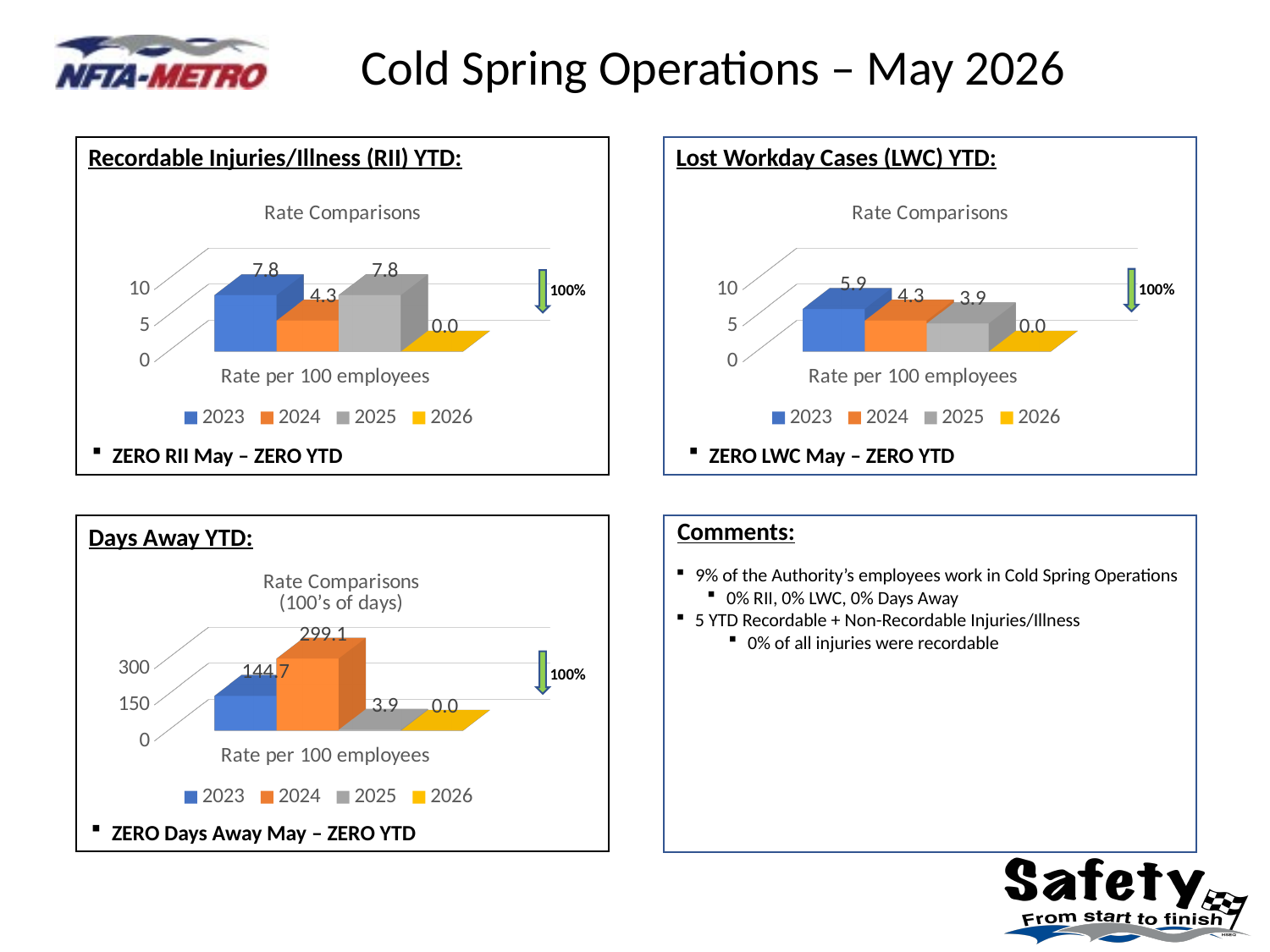
In the Recordable Injuries/Illness (RII) YTD chart, what is the value for 2024? 4.3 In the Days Away YTD chart, is the value for 2024 greater or less than 150? greater What kind of chart is the Lost Workday Cases (LWC) YTD chart? Bar chart In the Days Away YTD chart, what is the difference between the 2024 and 2023 values? 154.4 In the Lost Workday Cases (LWC) YTD chart, which year has the highest value? 2023 In the Lost Workday Cases (LWC) YTD chart, what is the value for 2025? 3.9 How many series does the legend list in the Recordable Injuries/Illness (RII) YTD chart? 4 In the Recordable Injuries/Illness (RII) YTD chart, which is larger, the value for 2023 or the value for 2024? 2023 In the Recordable Injuries/Illness (RII) YTD chart, what is the value for 2026? 0.0 In the Lost Workday Cases (LWC) YTD chart, what is the difference between the 2023 and 2024 values? 1.6 In the Days Away YTD chart, which year has the highest value? 2024 In the Days Away YTD chart, what is the value for 2023? 144.7